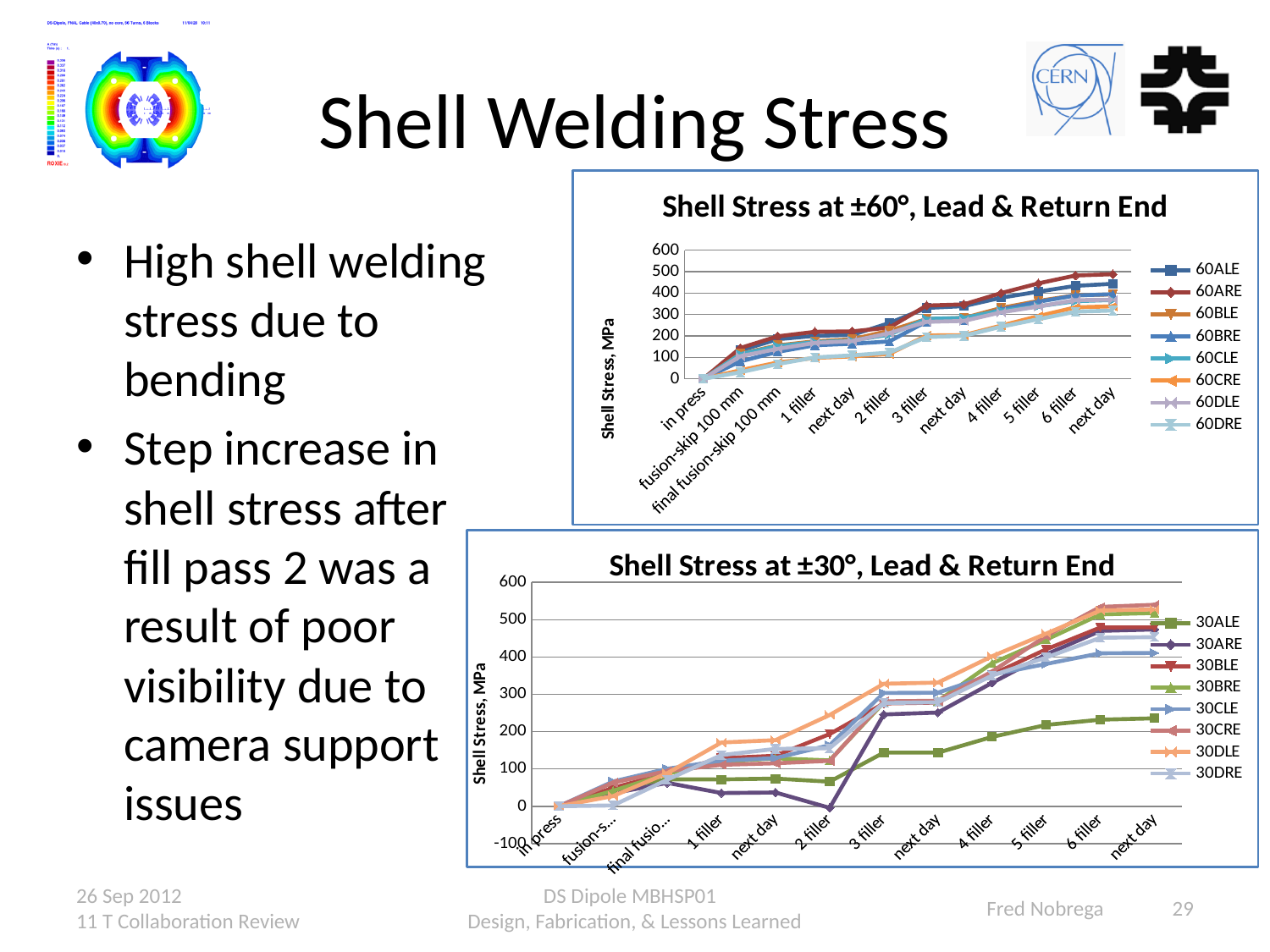
In the bottom chart, 'Shell Stress at ±30°, Lead & Return End', which series has the lowest value at the final 'next day' point? 30ALE In the bottom chart, 'Shell Stress at ±30°, Lead & Return End', is the value for 30ALE at the final 'next day' point greater or less than 300? less In the bottom chart, 'Shell Stress at ±30°, Lead & Return End', at '2 filler' which is larger, 30ARE or 30DLE? 30DLE How many categories are shown along the x axis of the top chart, 'Shell Stress at ±60°, Lead & Return End'? 12 What kind of chart is the top chart, 'Shell Stress at ±60°, Lead & Return End'? line chart In the top chart, 'Shell Stress at ±60°, Lead & Return End', is the value for 60DRE at the final 'next day' point greater or less than 400? less How many series does the legend of the top chart, 'Shell Stress at ±60°, Lead & Return End', list? 8 In the top chart, 'Shell Stress at ±60°, Lead & Return End', which series has the highest value at the final 'next day' point? 60ARE How many series does the legend of the bottom chart, 'Shell Stress at ±30°, Lead & Return End', list? 8 In the top chart, 'Shell Stress at ±60°, Lead & Return End', do the series values generally rise or fall from 'in press' to the final 'next day'? rise What is the y-axis label of the bottom chart, 'Shell Stress at ±30°, Lead & Return End'? Shell Stress, MPa In the bottom chart, 'Shell Stress at ±30°, Lead & Return End', is the value for 30DLE at '6 filler' greater or less than 500? greater